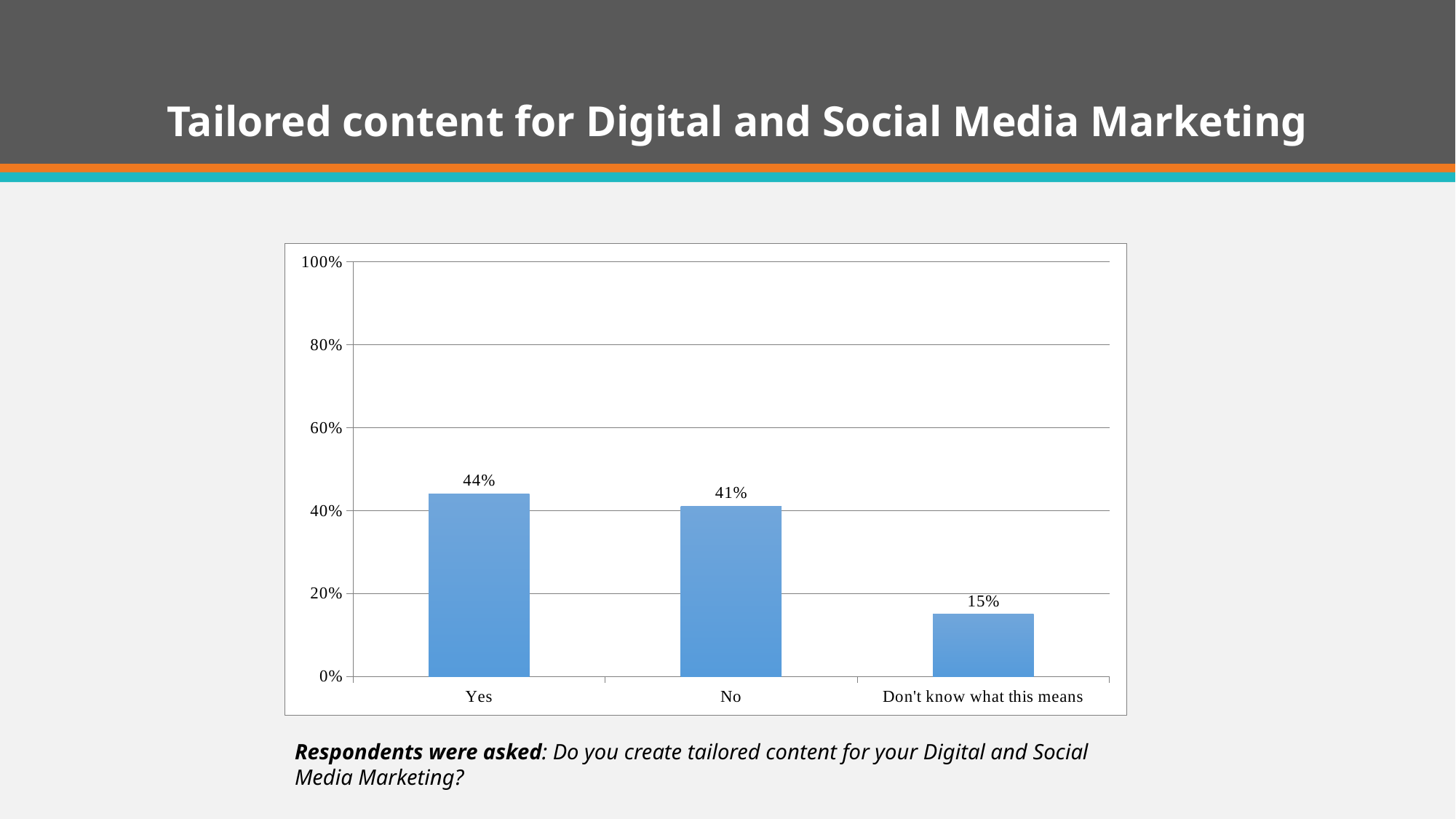
What percentage of respondents answered "No"? 41% Which is larger, the value for "Yes" or the value for "Don't know what this means"? Yes What percentage of respondents answered "Don't know what this means"? 15% What is the difference between the "No" and "Don't know what this means" values? 26% How many response categories are shown on the chart? 3 What type of chart is shown on the slide? Bar chart What percentage of respondents answered "Yes"? 44% What is the difference between the "Yes" and "No" values? 3% What is the maximum value shown on the vertical axis? 100% Which response category has the highest value? Yes Which response category has the lowest value? Don't know what this means Is the value for "No" greater or less than 60%? less